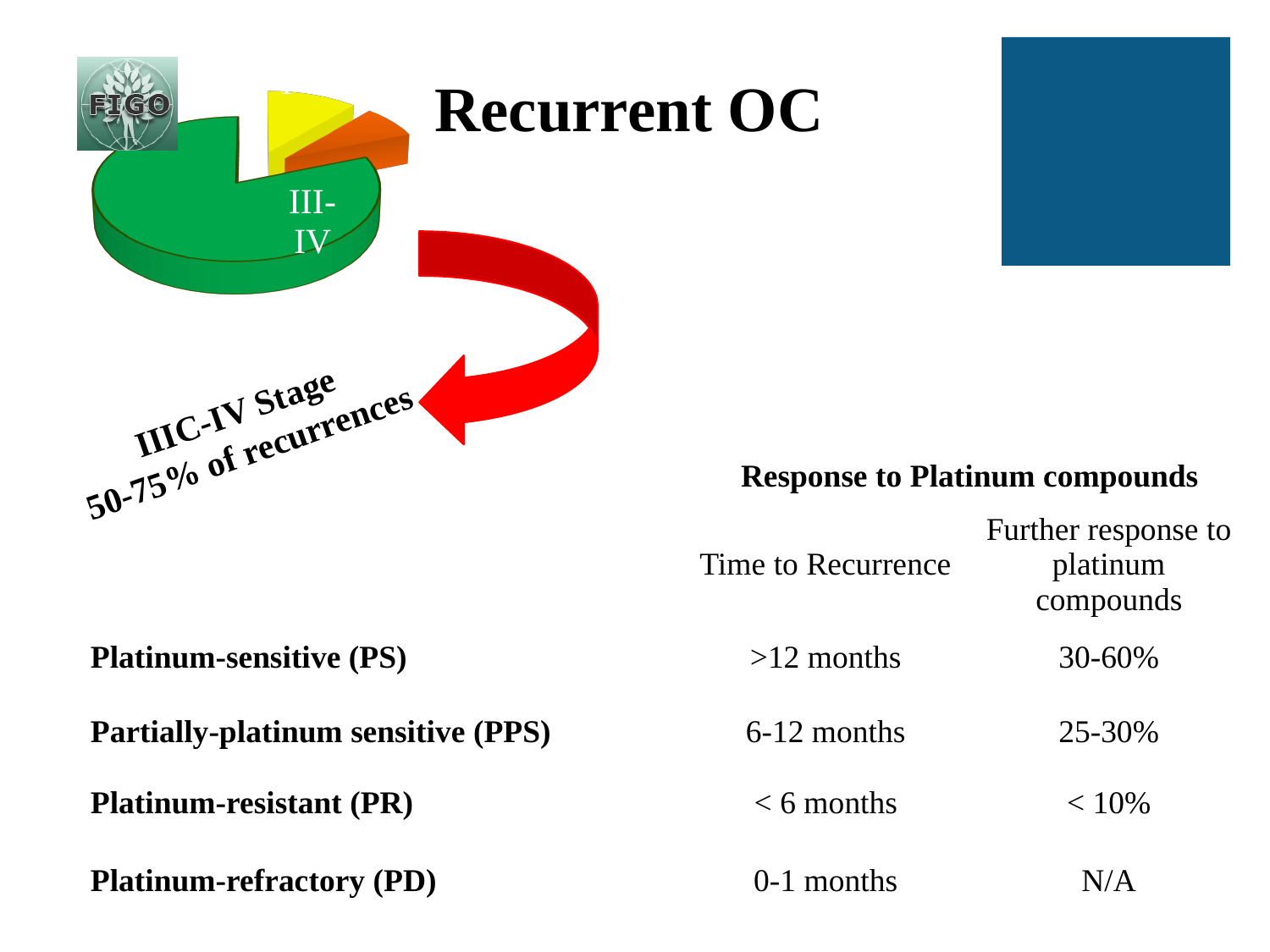
Is the green slice of the pie chart larger or smaller than the yellow slice? larger What label is printed on the largest slice of the pie chart? III-IV Does the largest slice of the pie chart take up more or less than half of the pie? more What kind of chart is shown at the top left of the slide? pie chart How many slices does the pie chart have? 3 Is the orange slice of the pie chart larger or smaller than the green slice? smaller Which slice of the pie chart is the largest? III-IV What colour is the slice labelled III-IV in the pie chart? green